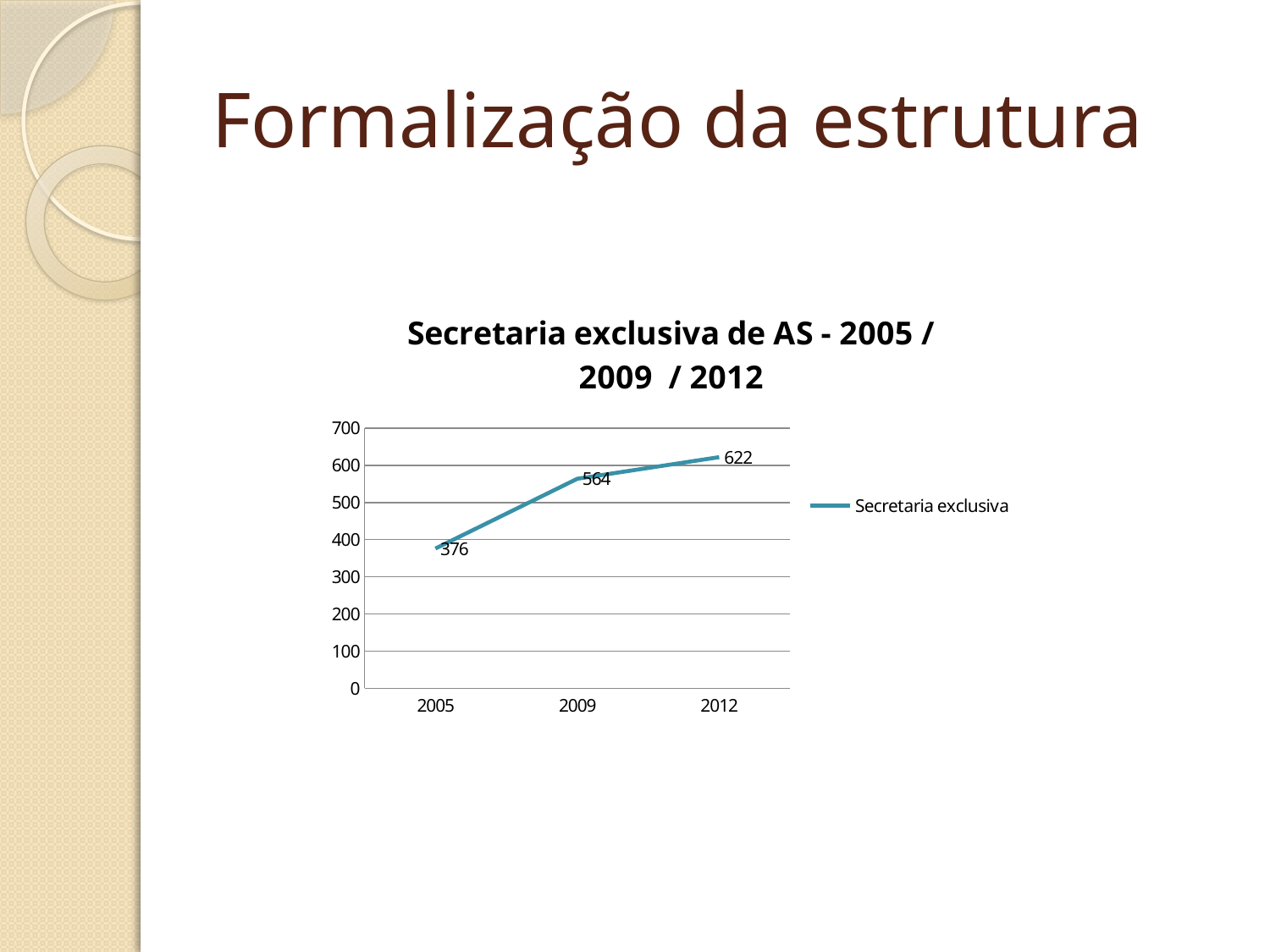
How many years are plotted on the chart? 3 Which year has the highest value? 2012 What is the value for 2009? 564 Do the values rise or fall from 2005 to 2012? rise What is the difference between the values for 2012 and 2009? 58 Which is larger, the value for 2005 or the value for 2009? 2009 Is the value for 2012 greater or less than 600? greater Which year has the lowest value? 2005 What is the difference between the values for 2009 and 2005? 188 What is the value for 2012? 622 What kind of chart is shown on the slide? line chart What is the value for 2005? 376